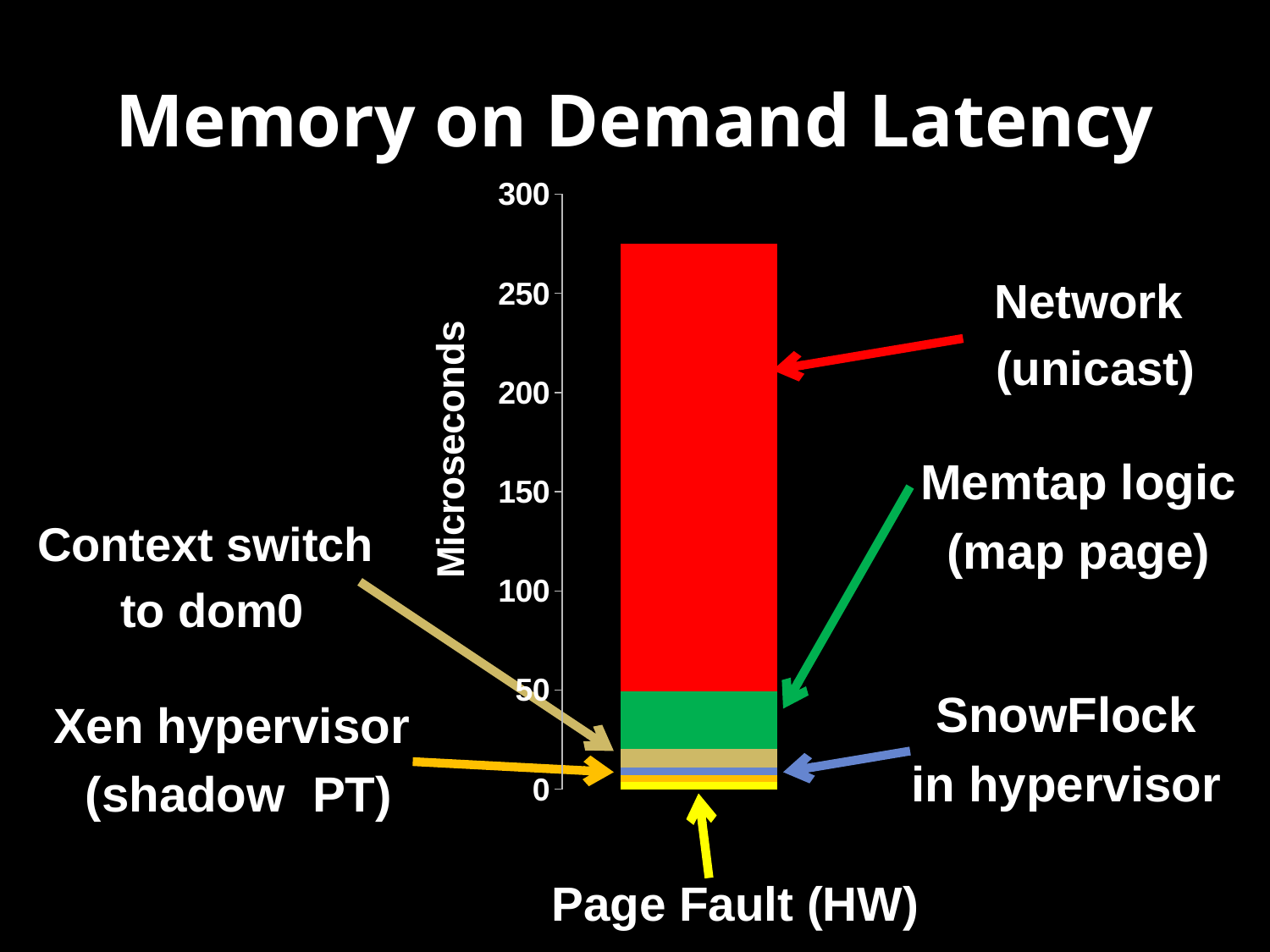
What kind of chart is shown on the slide? stacked bar chart What is the title of the chart on the slide? Memory on Demand Latency How many labelled components make up the stacked bar? 6 How many bars are plotted in the chart? 1 Which component accounts for the largest share of the stacked bar? Network (unicast) What is the label on the vertical axis of the chart? Microseconds Is the Network (unicast) segment greater or less than 200 microseconds? greater Is the combined height of all components below Network (unicast) greater or less than 100 microseconds? less Which is larger, the Memtap logic (map page) segment or the Page Fault (HW) segment? Memtap logic (map page) Is the total height of the stacked bar greater or less than 300 microseconds? less Which is larger, the Network (unicast) segment or the Memtap logic (map page) segment? Network (unicast)